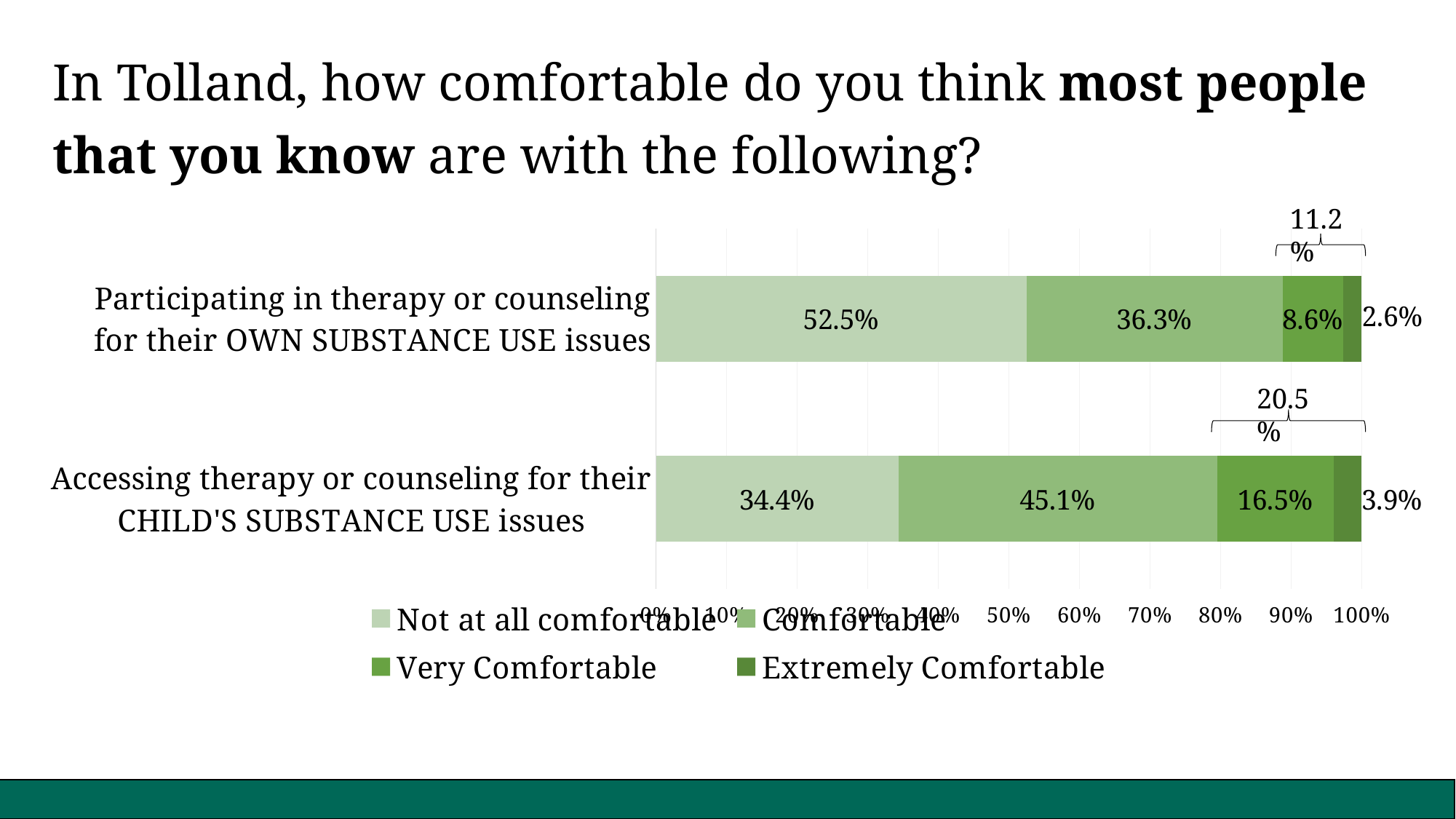
What is the difference between the 'Not at all comfortable' values for the OWN SUBSTANCE USE and CHILD'S SUBSTANCE USE categories? 18.1% What percentage of respondents think most people they know are 'Not at all comfortable' participating in therapy or counseling for their OWN SUBSTANCE USE issues? 52.5% Which category has the higher 'Not at all comfortable' value? Participating in therapy or counseling for their OWN SUBSTANCE USE issues What is the 'Extremely Comfortable' value for accessing therapy or counseling for their CHILD'S SUBSTANCE USE issues? 3.9% What is the 'Very Comfortable' value for participating in therapy or counseling for their OWN SUBSTANCE USE issues? 8.6% How many categories are plotted on the chart? 2 What is the difference between the 'Very Comfortable' values for the CHILD'S SUBSTANCE USE and OWN SUBSTANCE USE categories? 7.9% What kind of chart is shown on the slide? Stacked bar chart What combined percentage is shown by the bracket above the CHILD'S SUBSTANCE USE bar? 20.5% What combined percentage is shown by the bracket above the OWN SUBSTANCE USE bar? 11.2% How many series does the legend list? 4 What is the 'Comfortable' value for accessing therapy or counseling for their CHILD'S SUBSTANCE USE issues? 45.1%